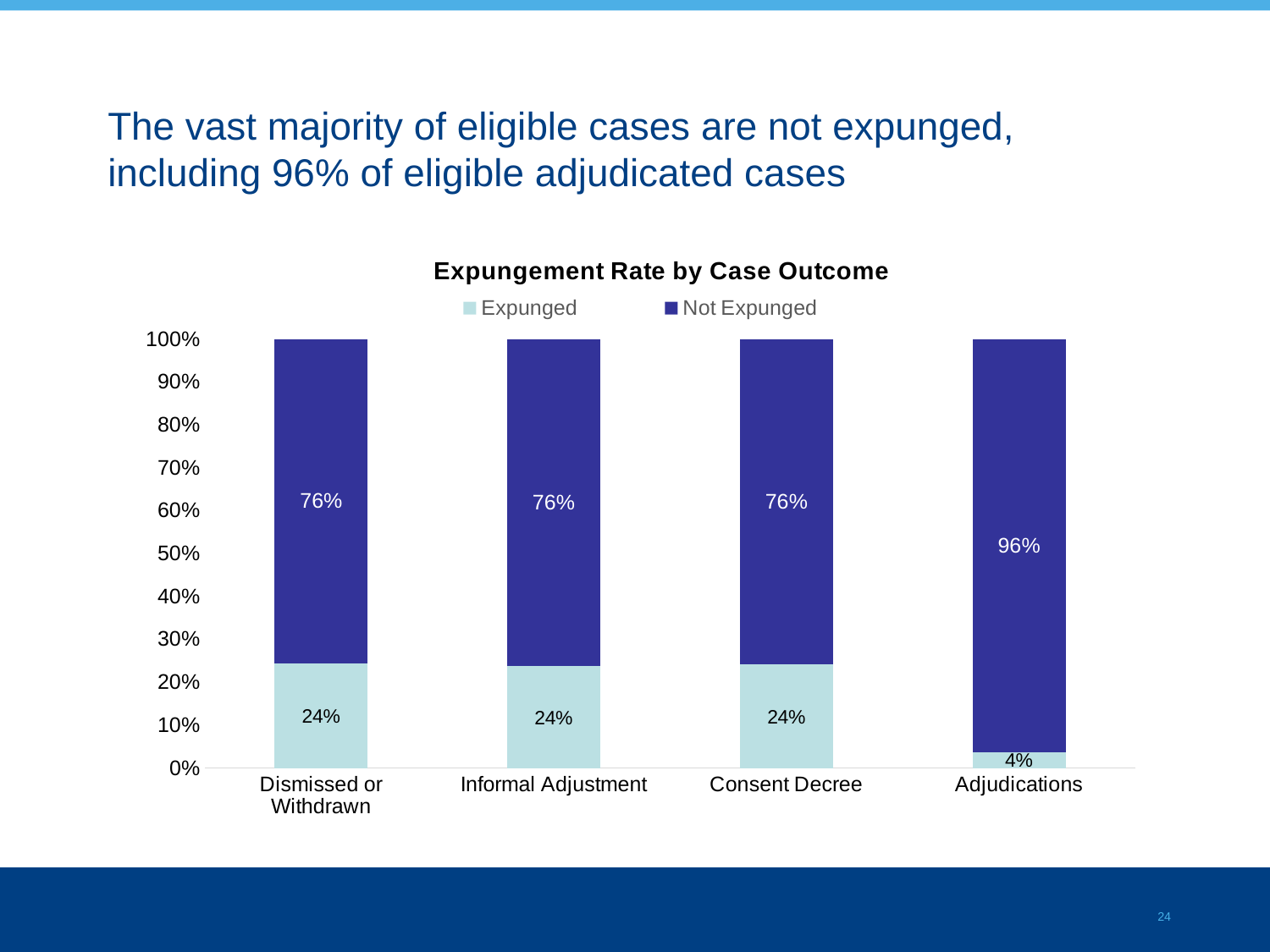
Which case outcome has the lowest Expunged share? Adjudications How many case outcome categories are shown on the x axis? 4 What kind of chart is shown on the slide? Stacked bar chart What is the title of the chart? Expungement Rate by Case Outcome Is the Expunged value for Dismissed or Withdrawn greater or less than 30%? less Which case outcome has the highest Not Expunged share? Adjudications What is the difference between the Not Expunged value for Adjudications and the Not Expunged value for Dismissed or Withdrawn? 20% What is the Not Expunged value for Consent Decree? 76% Which is larger: the Expunged value for Consent Decree or the Expunged value for Adjudications? Consent Decree What is the Expunged value for Adjudications? 4% How many series does the legend list? 2 What is the Expunged value for Informal Adjustment? 24%